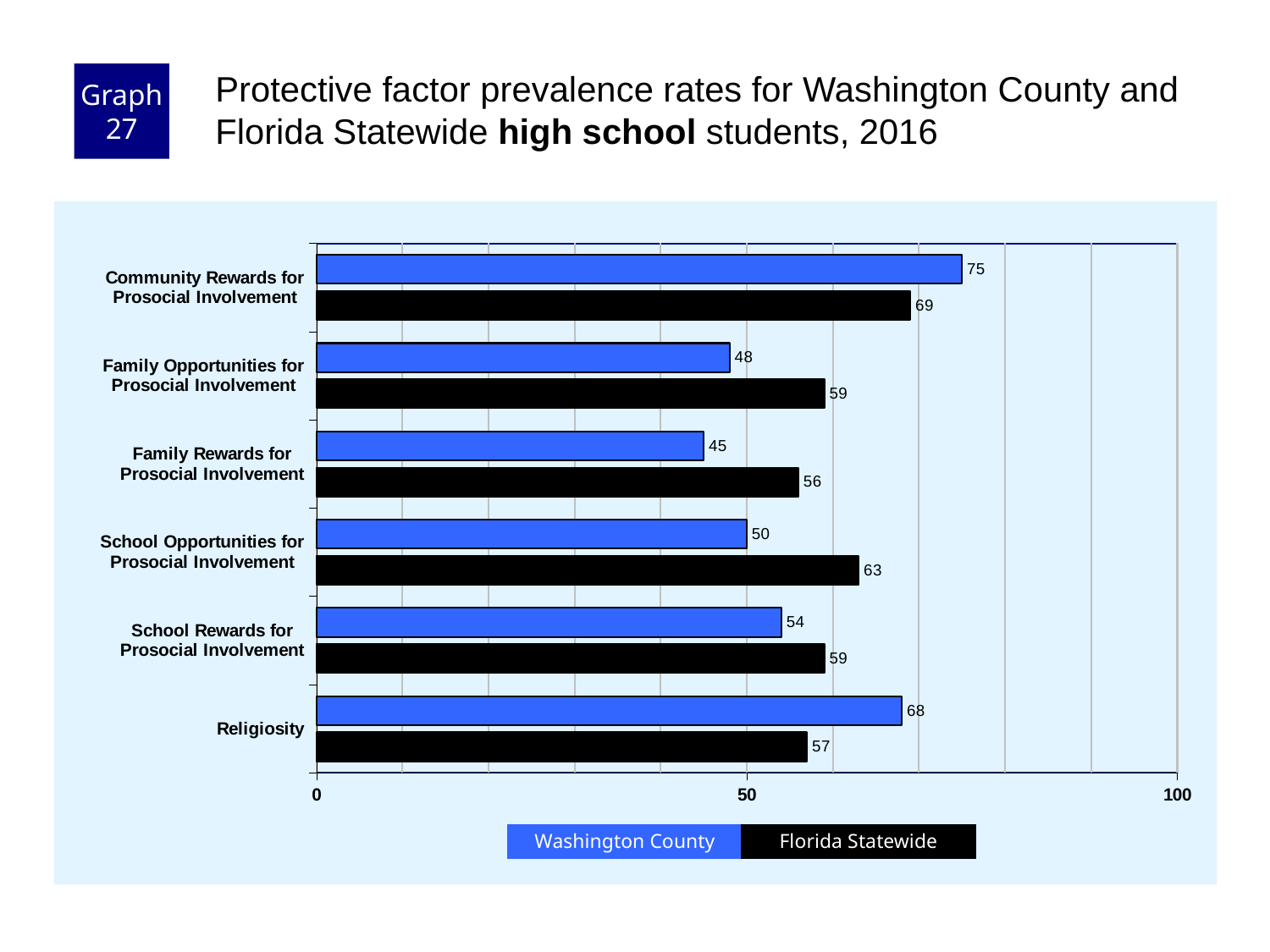
Which protective factor has the highest Washington County value? Community Rewards for Prosocial Involvement What type of chart is shown on the slide? Bar chart Is the Washington County value for Family Rewards for Prosocial Involvement greater or less than 50? less What is the Washington County value for Community Rewards for Prosocial Involvement? 75 For School Rewards for Prosocial Involvement, which is larger: Washington County or Florida Statewide? Florida Statewide How many protective factors are shown on the chart? 6 How many series does the legend list? 2 What is the Washington County value for Religiosity? 68 What is the difference between the Florida Statewide and Washington County values for Family Opportunities for Prosocial Involvement? 11 What is the Florida Statewide value for School Opportunities for Prosocial Involvement? 63 Which protective factor has the lowest Washington County value? Family Rewards for Prosocial Involvement Which protective factor has the lowest Florida Statewide value? Family Rewards for Prosocial Involvement